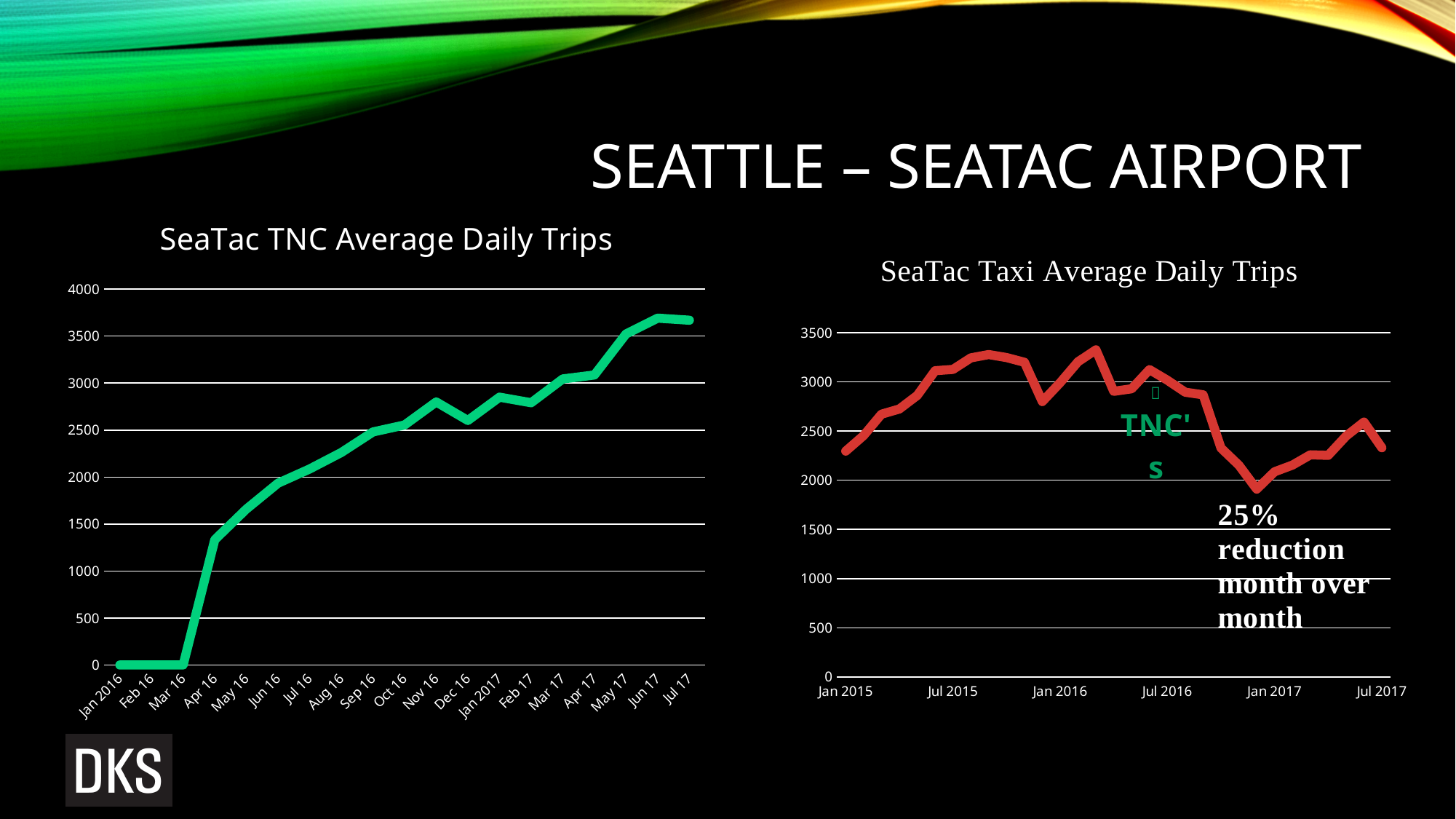
What kind of chart is the SeaTac Taxi Average Daily Trips chart? line chart In the SeaTac Taxi Average Daily Trips chart, is the value for Jan 2015 greater or less than 2500? less What kind of chart is the SeaTac TNC Average Daily Trips chart? line chart In the SeaTac TNC Average Daily Trips chart, do the values generally rise or fall from Jan 2016 to Jul 17? rise What colour is the line in the SeaTac Taxi Average Daily Trips chart? red In the SeaTac TNC Average Daily Trips chart, what is the value for Jan 2016? 0 In the SeaTac Taxi Average Daily Trips chart, is the value for Jan 2016 greater or less than 2500? greater In the SeaTac TNC Average Daily Trips chart, how many months are labelled on the x axis? 19 In the SeaTac TNC Average Daily Trips chart, what is the value for Mar 16? 0 In the SeaTac TNC Average Daily Trips chart, is the value for Apr 16 greater or less than 1500? less